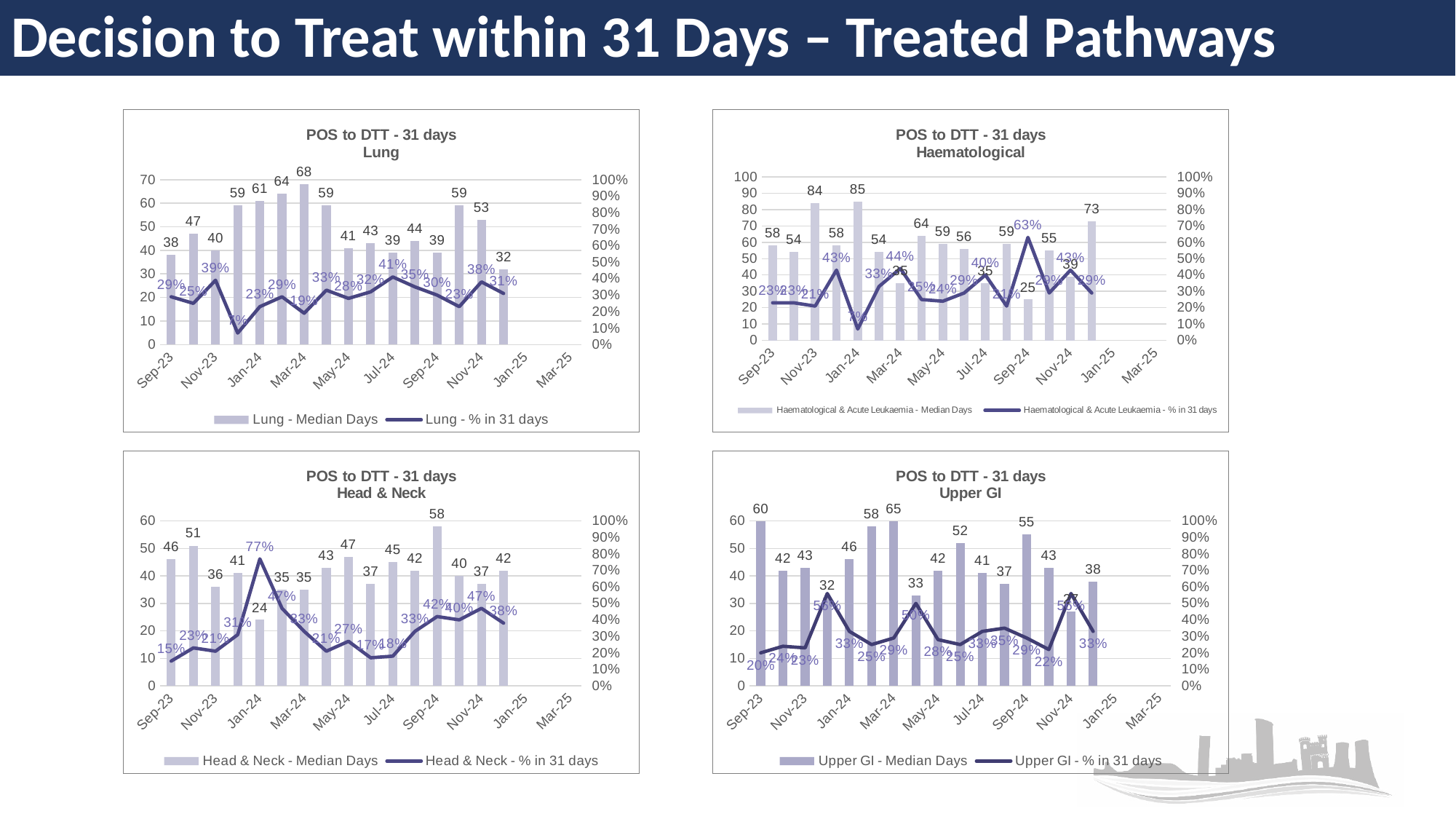
In the 'POS to DTT - 31 days Haematological' chart, what is the highest median days value? 85 In the 'POS to DTT - 31 days Lung' chart, what is the lowest value on the '% in 31 days' line? 7% What kind of chart is the 'POS to DTT - 31 days Upper GI' chart? Combined bar and line chart In the 'POS to DTT - 31 days Haematological' chart, what is the lowest median days value? 25 In the 'POS to DTT - 31 days Head & Neck' chart, what is the median days value for Sep-24? 58 In the 'POS to DTT - 31 days Head & Neck' chart, what is the highest '% in 31 days' value? 77% In the 'POS to DTT - 31 days Lung' chart, what is the median days value for Sep-23? 38 In the 'POS to DTT - 31 days Upper GI' chart, what is the median days value for Mar-24? 65 In the 'POS to DTT - 31 days Haematological' chart, which month has the higher median days, Nov-23 or Mar-24? Nov-23 In the 'POS to DTT - 31 days Lung' chart, what is the difference between the median days for Mar-24 and Sep-23? 30 In the 'POS to DTT - 31 days Lung' chart, what is the highest median days value shown? 68 How many series does the legend of the 'POS to DTT - 31 days Lung' chart list? 2